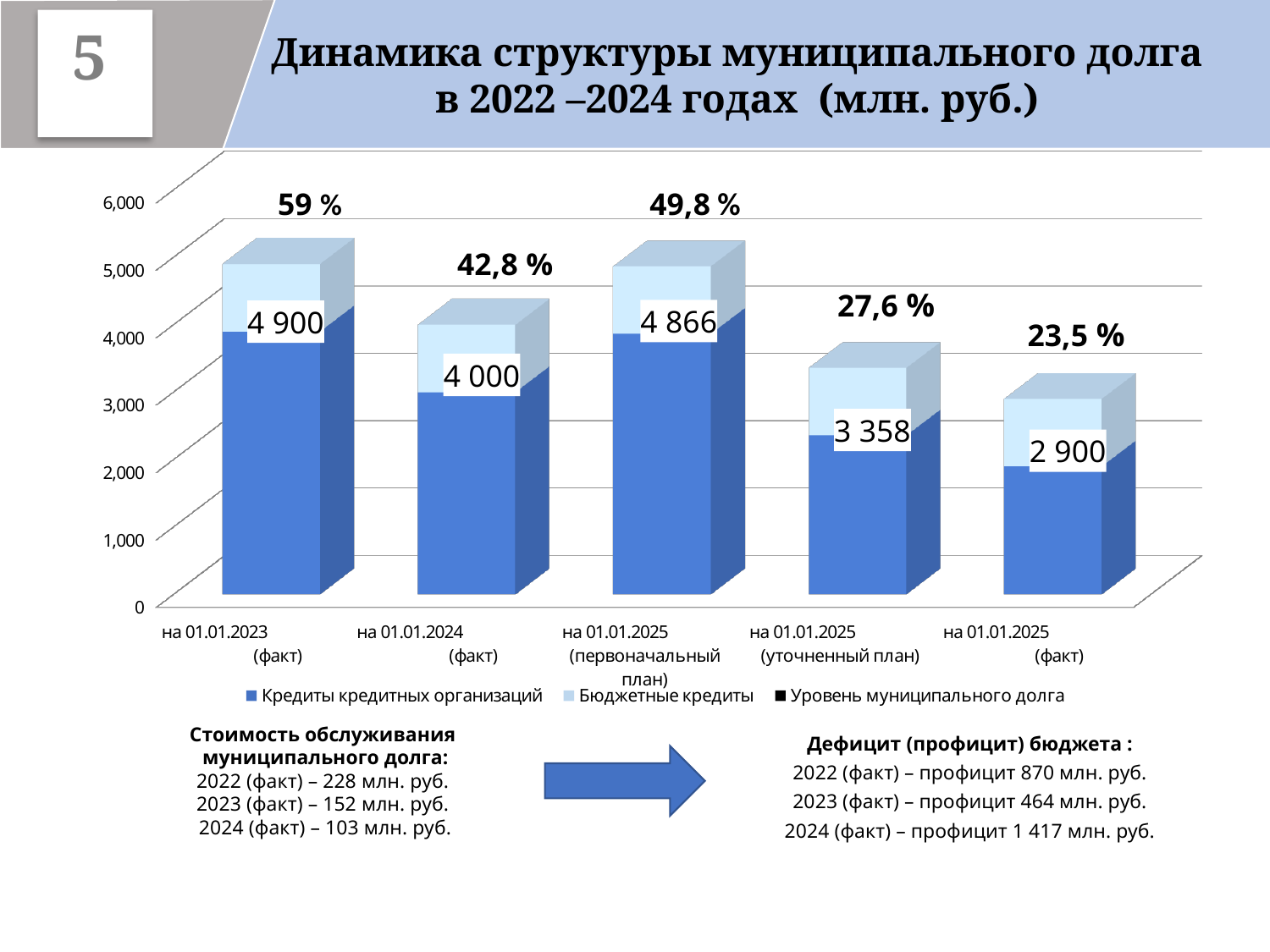
What is the labelled value for на 01.01.2025 (факт)? 2 900 What is the difference between the labelled values for на 01.01.2023 (факт) and на 01.01.2025 (факт)? 2 000 How many series does the legend list? 3 Is the dark blue segment (Кредиты кредитных организаций) for на 01.01.2023 (факт) greater or less than 3,000? greater How many categories are shown on the x axis? 5 Which category has the highest labelled value? на 01.01.2023 (факт) Which category has the lowest labelled value? на 01.01.2025 (факт) What percentage is printed above the bar for на 01.01.2024 (факт)? 42,8 % What kind of chart is shown on the slide? stacked bar chart What is the labelled value for на 01.01.2023 (факт)? 4 900 Which is larger: the labelled value for на 01.01.2024 (факт) or for на 01.01.2025 (первоначальный план)? на 01.01.2025 (первоначальный план) What is the labelled value for на 01.01.2025 (уточненный план)? 3 358